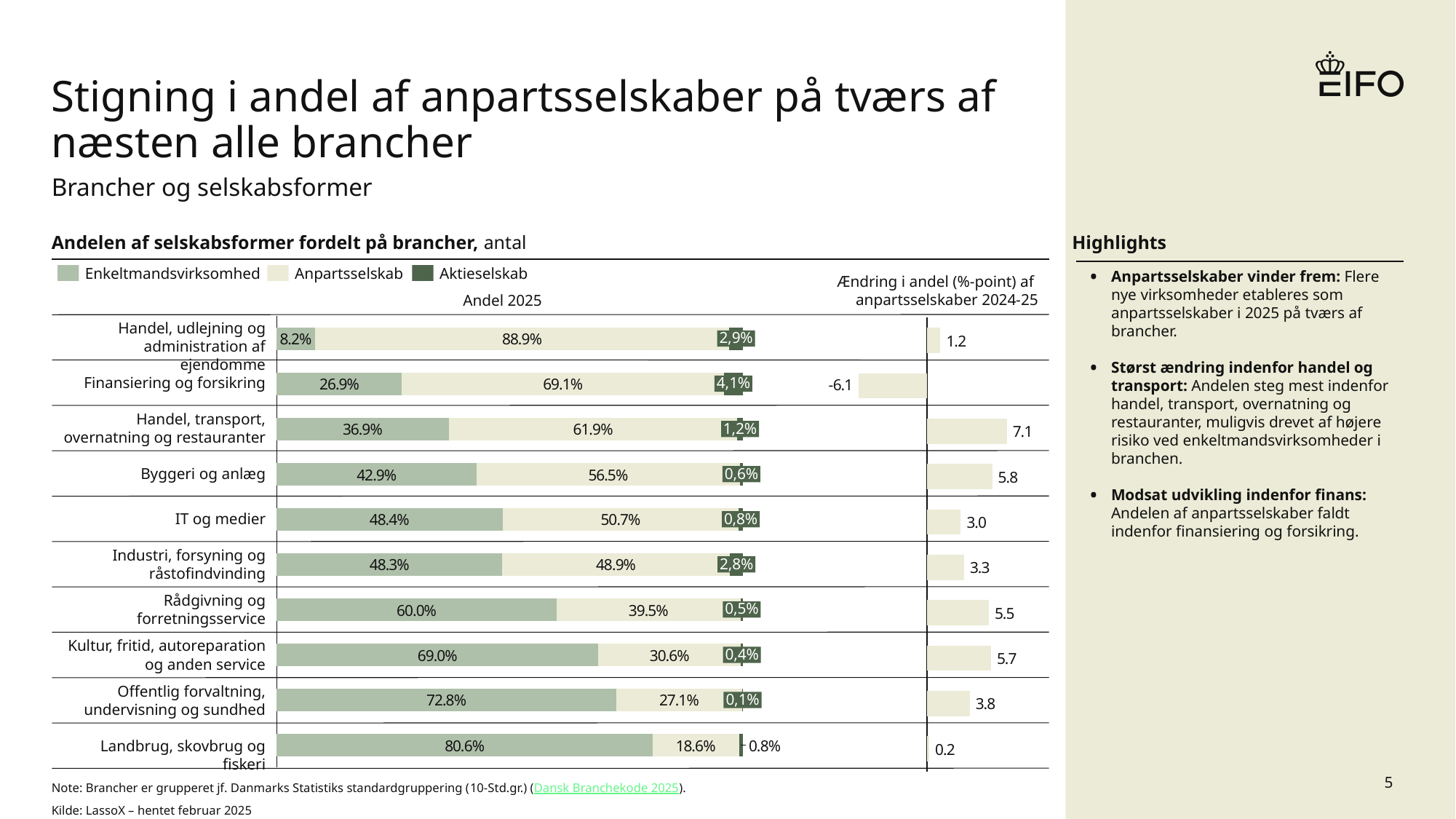
In the 'Andel 2025' chart, what is the Enkeltmandsvirksomhed share for Landbrug, skovbrug og fiskeri? 80.6% How many branches are shown in the 'Andel 2025' chart? 10 How many series does the legend of the 'Andel 2025' chart list? 3 In the 'Ændring i andel (%-point) af anpartsselskaber 2024-25' chart, what is the difference between the values for Byggeri og anlæg and IT og medier? 2.8 In the 'Ændring i andel (%-point) af anpartsselskaber 2024-25' chart, which branch has the highest value? Handel, transport, overnatning og restauranter In the 'Ændring i andel (%-point) af anpartsselskaber 2024-25' chart, which branch has the lowest value? Finansiering og forsikring In the 'Andel 2025' chart, which is larger: the Enkeltmandsvirksomhed share for Rådgivning og forretningsservice or for Byggeri og anlæg? Rådgivning og forretningsservice In the 'Andel 2025' chart, what is the Anpartsselskab share for Finansiering og forsikring? 69.1% In the 'Andel 2025' chart, which branch has the highest Anpartsselskab share? Handel, udlejning og administration af ejendomme In the 'Andel 2025' chart, what is the Aktieselskab share for Industri, forsyning og råstofindvinding? 2,8% What kind of chart is the 'Andel 2025' chart? Stacked bar chart In the 'Ændring i andel (%-point) af anpartsselskaber 2024-25' chart, what is the value for Handel, transport, overnatning og restauranter? 7.1